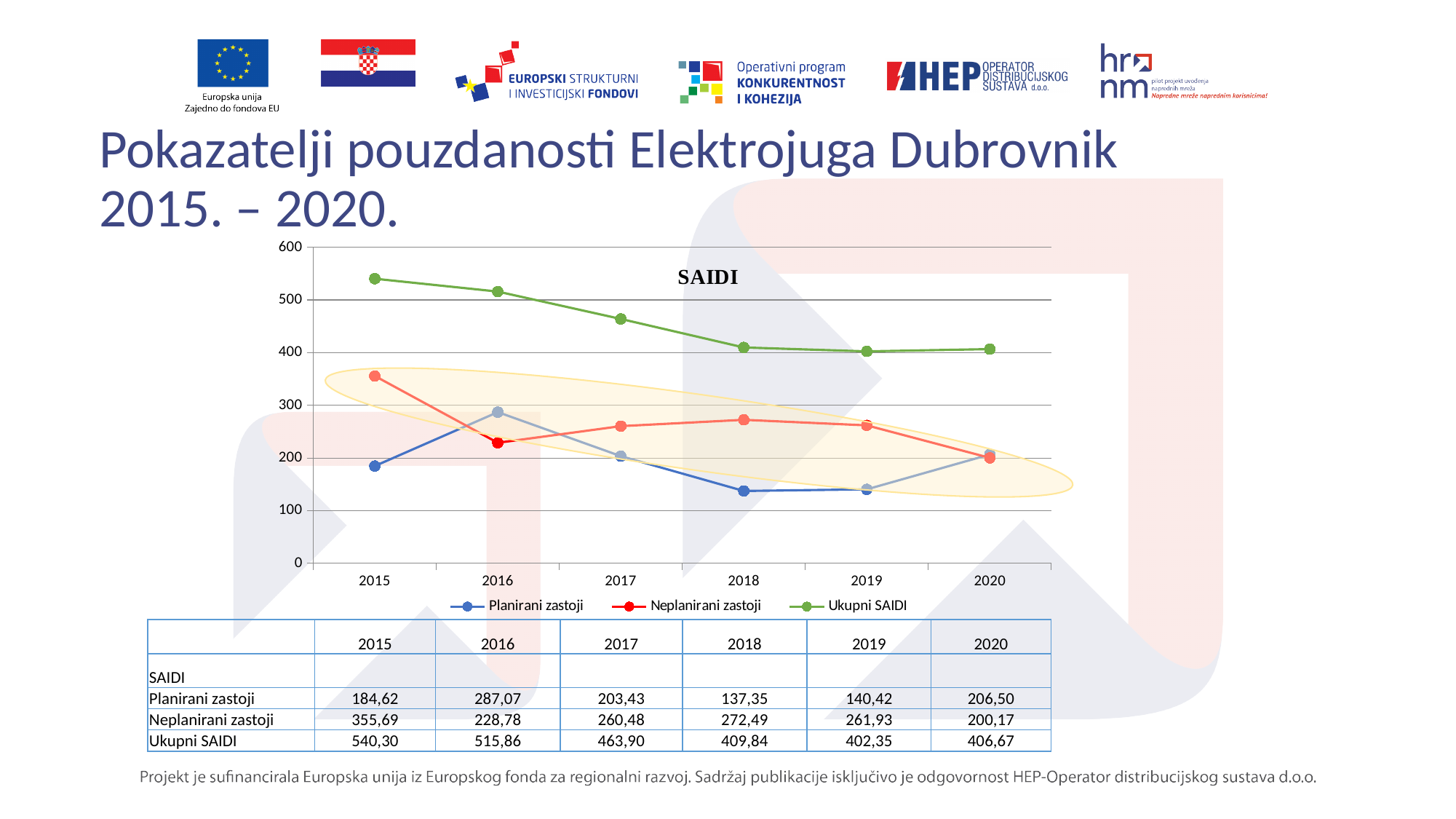
How many years are plotted along the x axis of the SAIDI chart? 6 In which year is Planirani zastoji highest? 2016 What type of chart is shown on the slide? line chart In which year is Neplanirani zastoji lowest? 2020 What is the difference between Ukupni SAIDI in 2015 and in 2020? 133,63 What is the value of Planirani zastoji in 2018? 137,35 What is the value of Ukupni SAIDI in 2015? 540,30 Which is larger in 2016: Planirani zastoji or Neplanirani zastoji? Planirani zastoji Does Ukupni SAIDI generally rise or fall from 2015 to 2019? fall How many series does the legend of the SAIDI chart list? 3 In which year is Ukupni SAIDI highest? 2015 What is the value of Neplanirani zastoji in 2020? 200,17